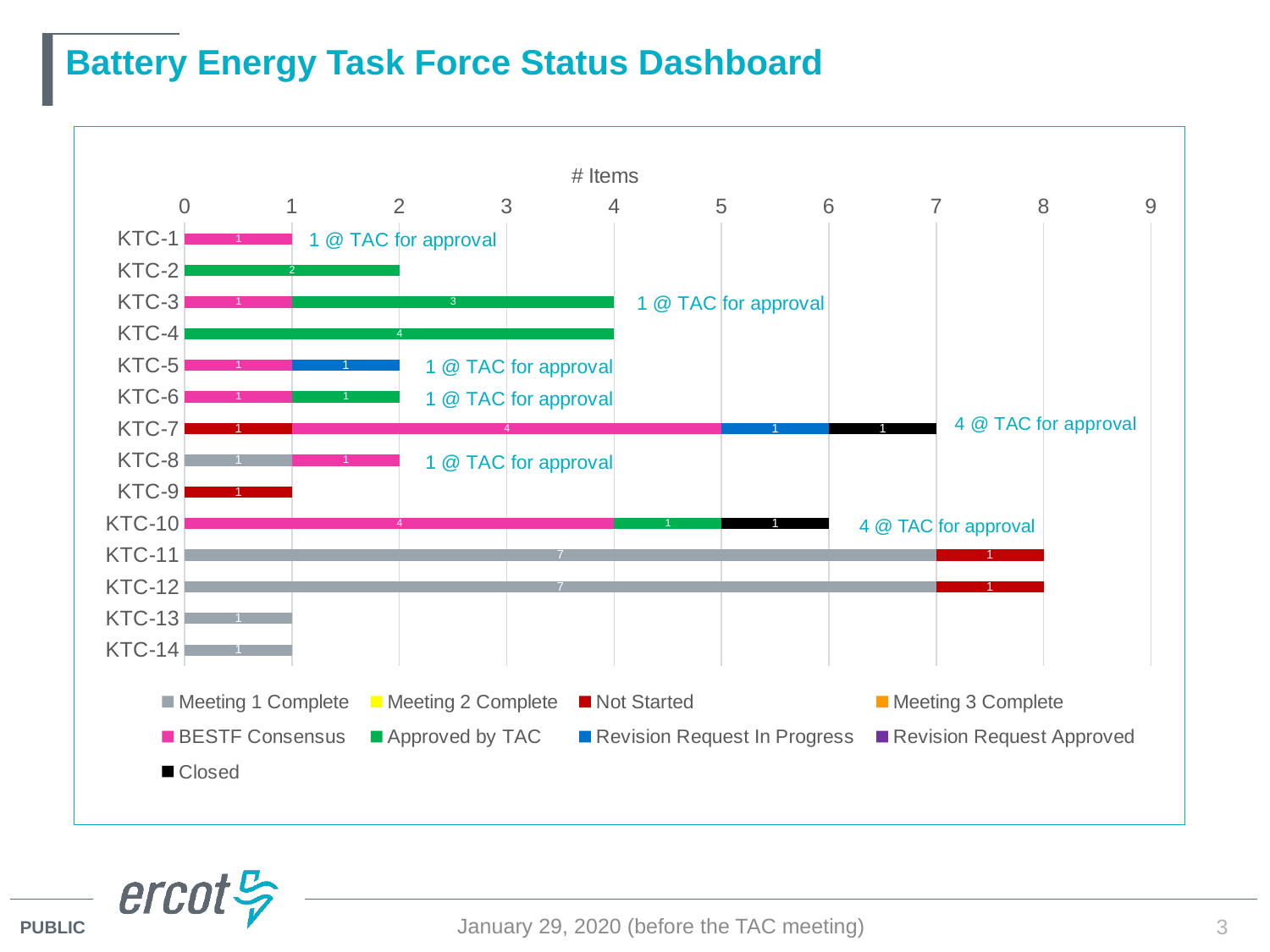
What is the title of the horizontal axis? # Items What is the total number of items in the KTC-10 bar? 6 Which category has the highest Approved by TAC value? KTC-4 What is the BESTF Consensus value for KTC-7? 4 What kind of chart is shown on the slide? Stacked bar chart How many series does the legend list? 9 What is the difference between the Approved by TAC values for KTC-3 and KTC-6? 2 What is the Approved by TAC value for KTC-4? 4 What is the total number of items in the KTC-7 bar? 7 How many KTC categories are plotted on the chart? 14 Which has a larger total bar, KTC-3 or KTC-2? KTC-3 What is the Meeting 1 Complete value for KTC-11? 7